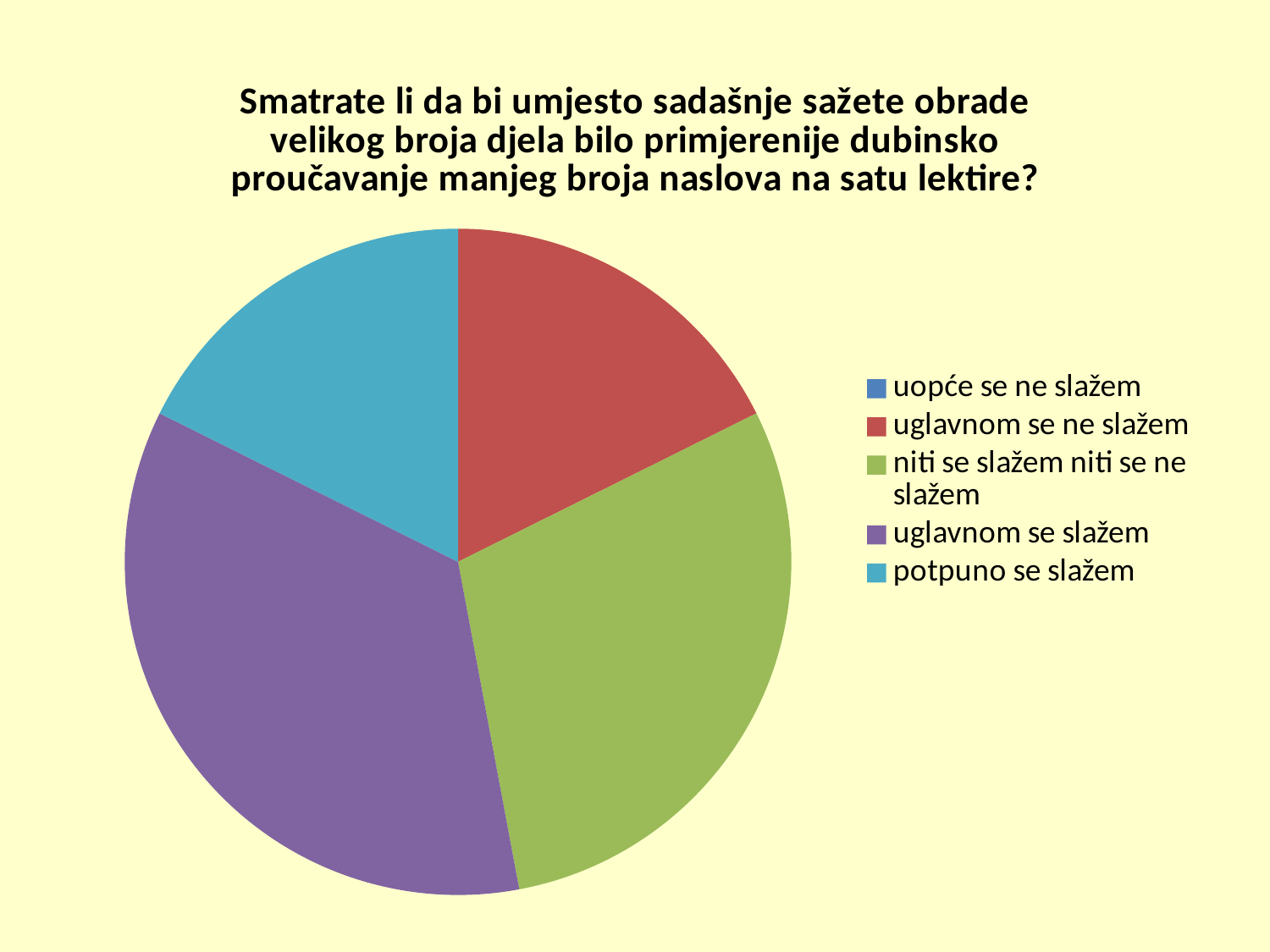
How many categories does the legend of the pie chart list? 5 What colour is the slice for "potpuno se slažem" in the pie chart? teal (light blue) Which legend entry of the pie chart has no visible slice? uopće se ne slažem Which slice is larger, "uglavnom se slažem" or "niti se slažem niti se ne slažem"? uglavnom se slažem Which category has the largest slice of the pie chart? uglavnom se slažem What kind of chart is shown on the slide? pie chart Which slice is larger, "uglavnom se slažem" or "potpuno se slažem"? uglavnom se slažem Which slice is larger, "niti se slažem niti se ne slažem" or "potpuno se slažem"? niti se slažem niti se ne slažem